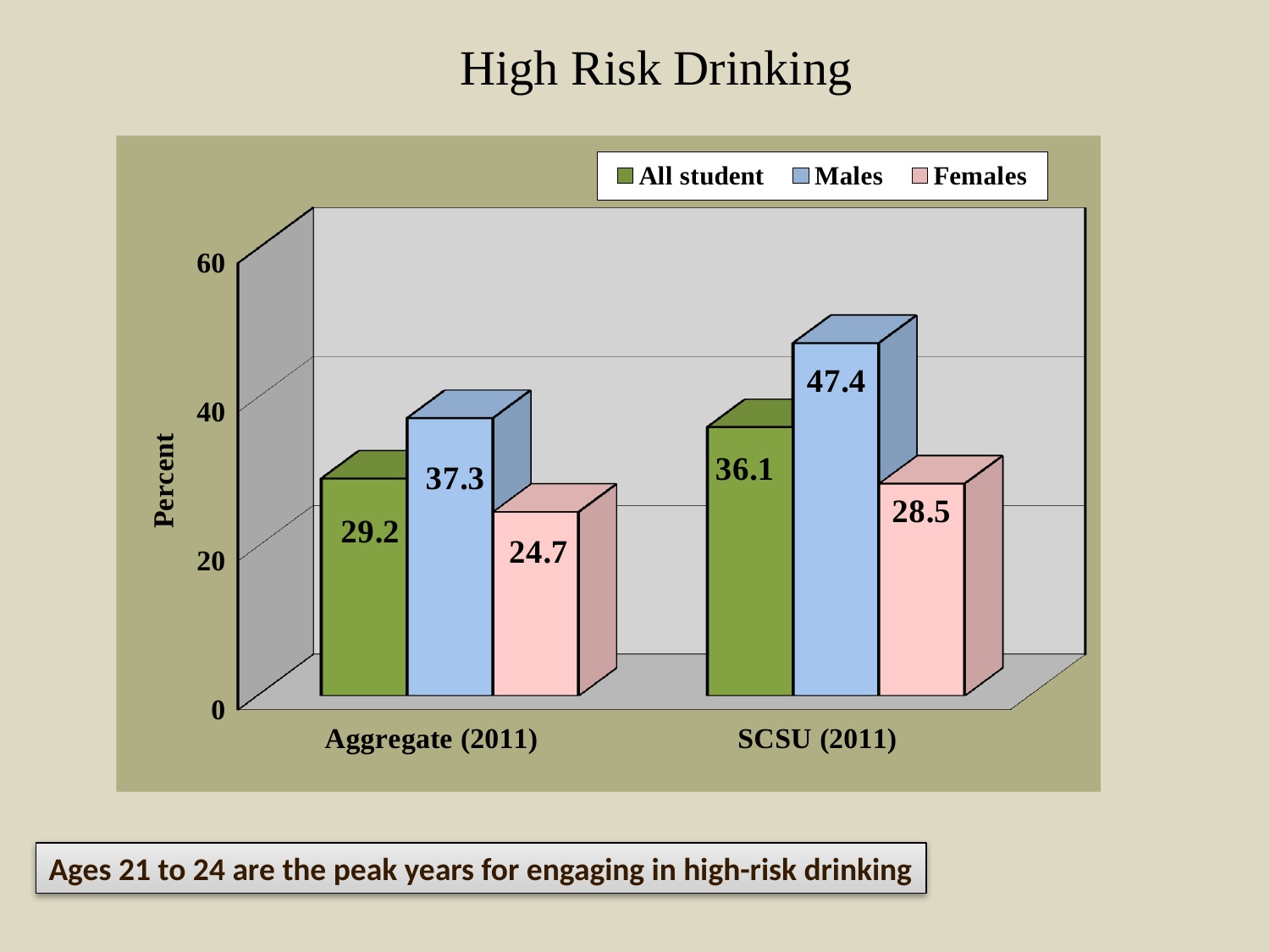
Which is larger: the Females value for SCSU (2011) or the All student value for Aggregate (2011)? Aggregate (2011) All student How many series does the legend list? 3 What is the value for Females in the SCSU (2011) category? 28.5 Which series has the highest value in the SCSU (2011) category? Males What kind of chart is shown on the slide? Bar chart What is the value for Males in the Aggregate (2011) category? 37.3 Is the value for Males in SCSU (2011) greater or less than 40? greater What is the difference between the Males values for SCSU (2011) and Aggregate (2011)? 10.1 Which series has the lowest value in the Aggregate (2011) category? Females What is the difference between the All student and Females values in the Aggregate (2011) category? 4.5 What is the value for All student in the SCSU (2011) category? 36.1 How many categories are shown on the x axis? 2